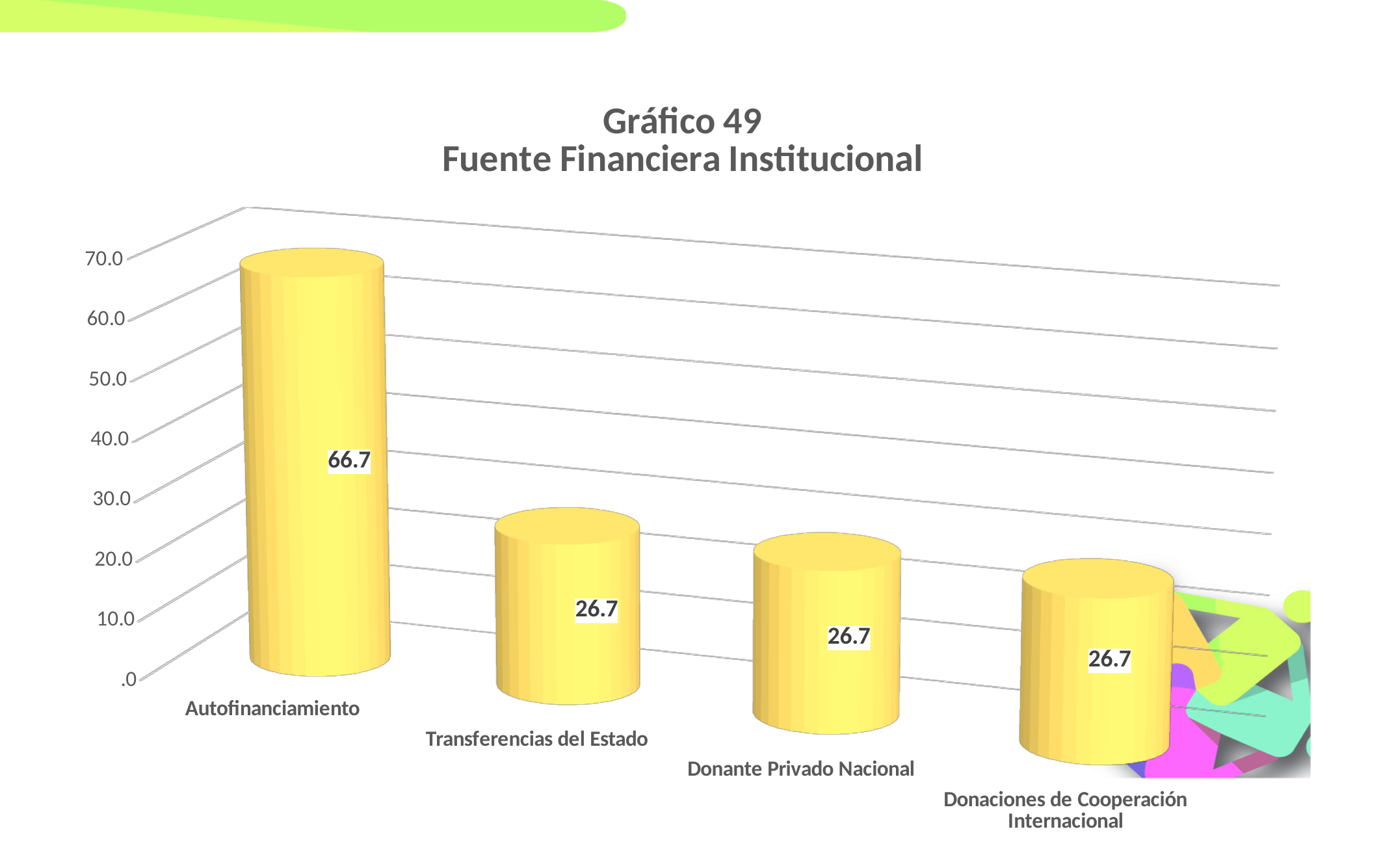
What is the value for Donaciones de Cooperación Internacional? 26.7 What kind of chart is shown on the slide? bar chart Which category has the highest value? Autofinanciamiento What is the title of the chart? Gráfico 49 Fuente Financiera Institucional What is the value for Transferencias del Estado? 26.7 What is the value for Autofinanciamiento? 66.7 Which is larger, the value for Autofinanciamiento or the value for Donante Privado Nacional? Autofinanciamiento What is the difference between the values for Autofinanciamiento and Transferencias del Estado? 40.0 How many categories are shown in the chart? 4 What is the value for Donante Privado Nacional? 26.7 Is the value for Donaciones de Cooperación Internacional greater or less than 30.0? less Is the value for Autofinanciamiento greater or less than 60.0? greater